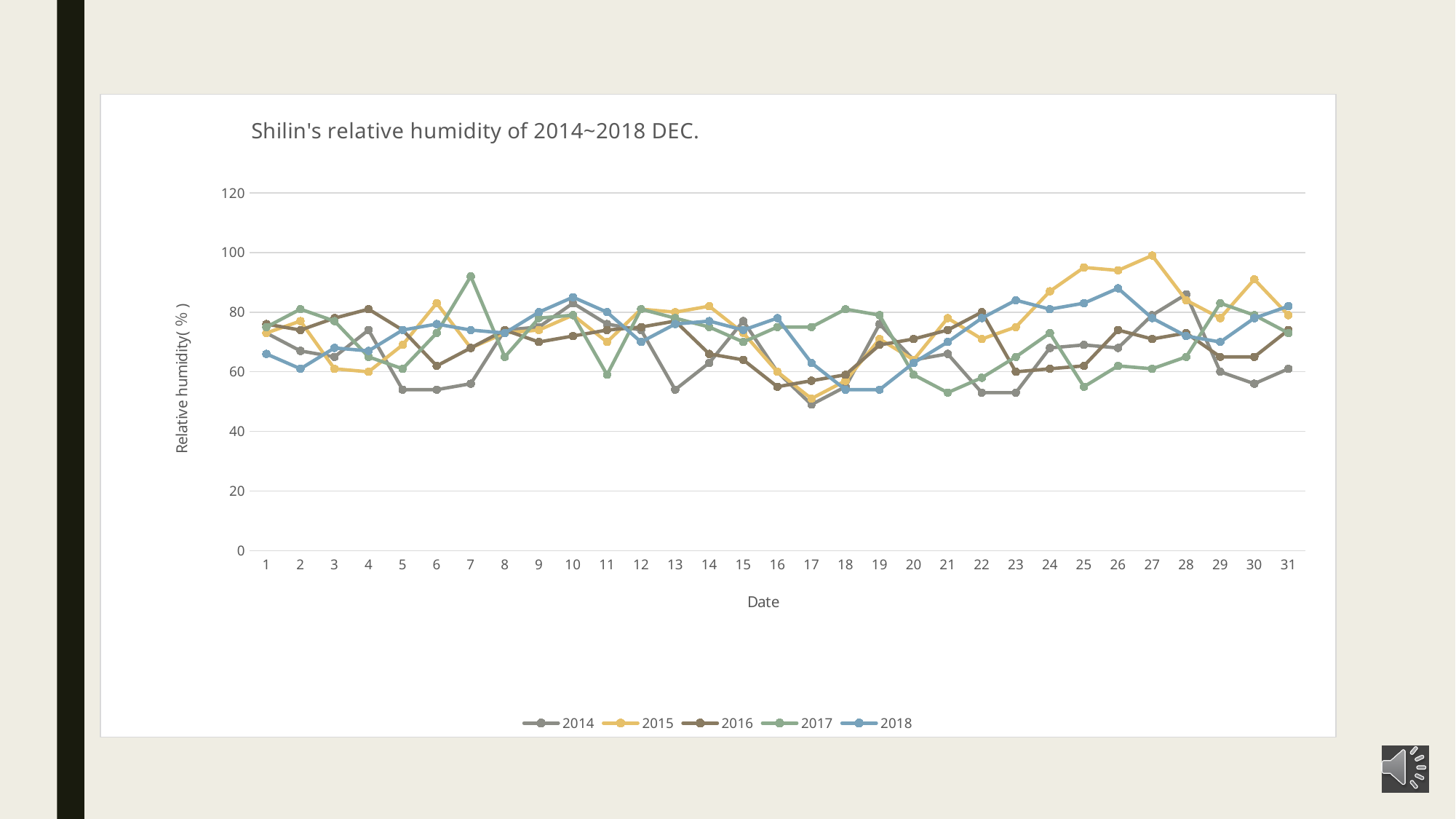
Which series reaches the highest value anywhere on the chart? 2015 What kind of chart is shown on the slide? line chart On date 7, which is higher, the 2017 value or the 2014 value? 2017 Is the value for 2014 on date 17 greater or less than 60? less How many series does the legend list? 5 How many dates are plotted along the x axis? 31 Is the value for 2015 on date 27 greater or less than 80? greater Is the value for 2018 on date 26 greater or less than 80? greater What is the label of the vertical axis? Relative humidity( % ) What is the title of the chart? Shilin's relative humidity of 2014~2018 DEC.